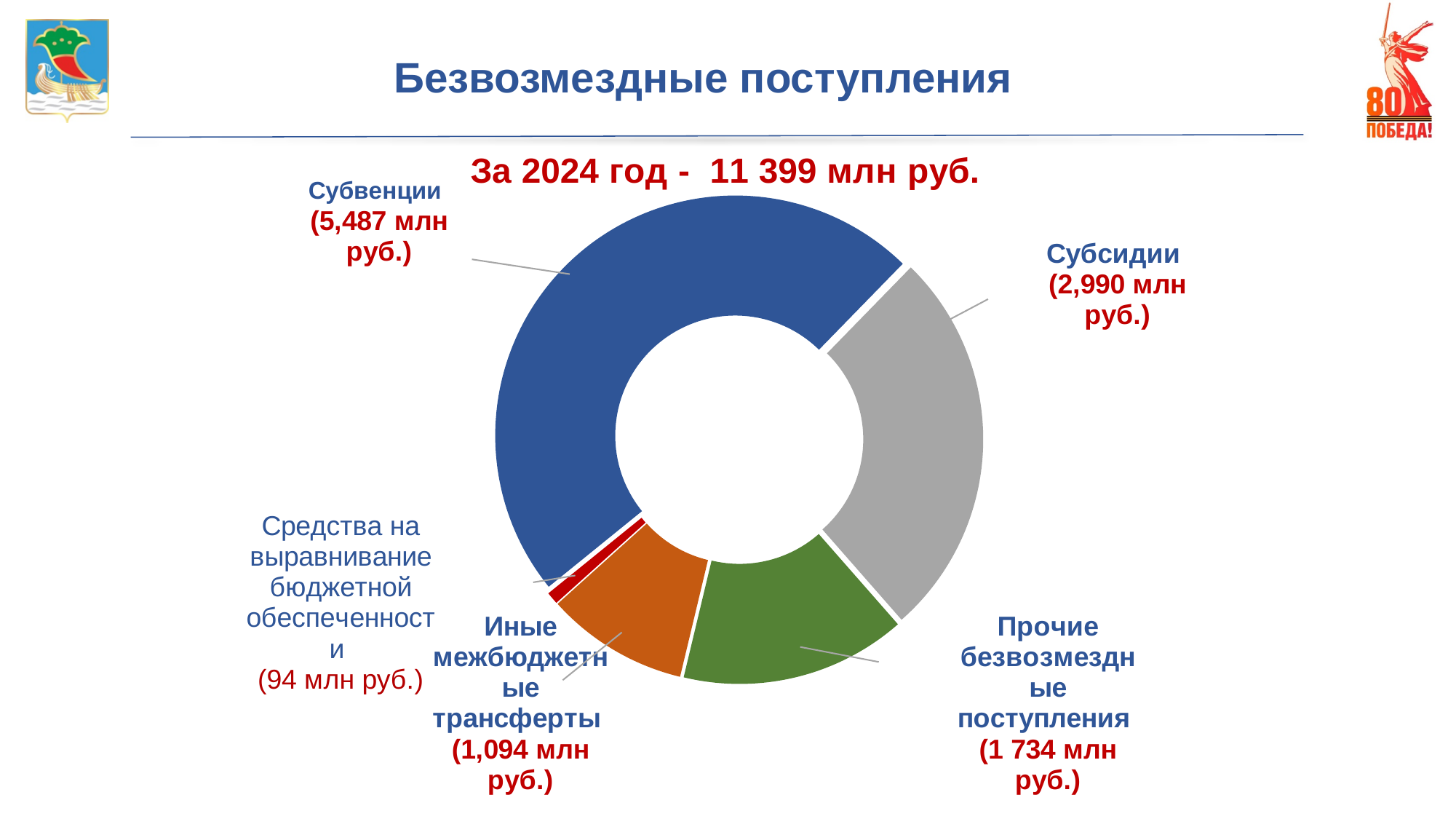
How many categories does the chart show? 5 What kind of chart is shown on the slide? Doughnut (pie) chart Which category has the largest value? Субвенции What total amount for 2024 is stated above the chart? 11 399 млн руб. What is the value for Субвенции? 5,487 млн руб. What is the value for Средства на выравнивание бюджетной обеспеченности? 94 млн руб. Which is larger, Субсидии or Прочие безвозмездные поступления? Субсидии How much larger is Иные межбюджетные трансферты than Средства на выравнивание бюджетной обеспеченности? 1,000 млн руб. What is the value for Прочие безвозмездные поступления? 1 734 млн руб. What is the value for Субсидии? 2,990 млн руб. Which category has the smallest value? Средства на выравнивание бюджетной обеспеченности What is the value for Иные межбюджетные трансферты? 1,094 млн руб.